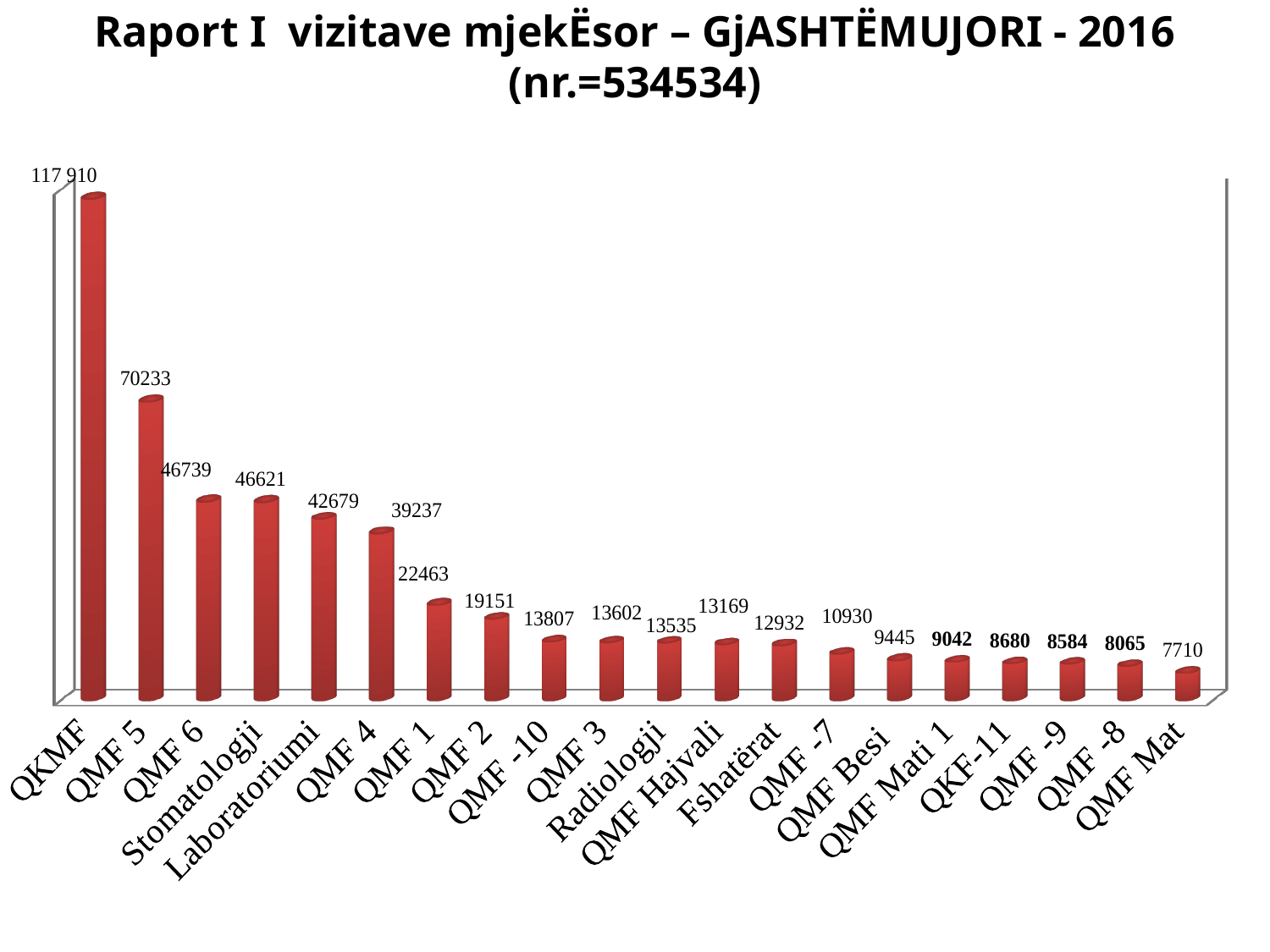
What is the value for QMF Hajvali? 13169 What kind of chart is this? Bar chart What is the value for Laboratoriumi? 42679 What is the value for QKF-11? 8680 What is the difference between the values for QMF 5 and QMF 6? 23494 Which category has the highest value? QKMF Which category has the lowest value? QMF Mat Do the values rise or fall from left to right along the x axis? Fall What is the difference between the values for QMF 1 and QMF 2? 3312 Which has a larger value, QMF 4 or QMF 1? QMF 4 What is the value for QMF 5? 70233 How many categories are shown on the x axis? 20